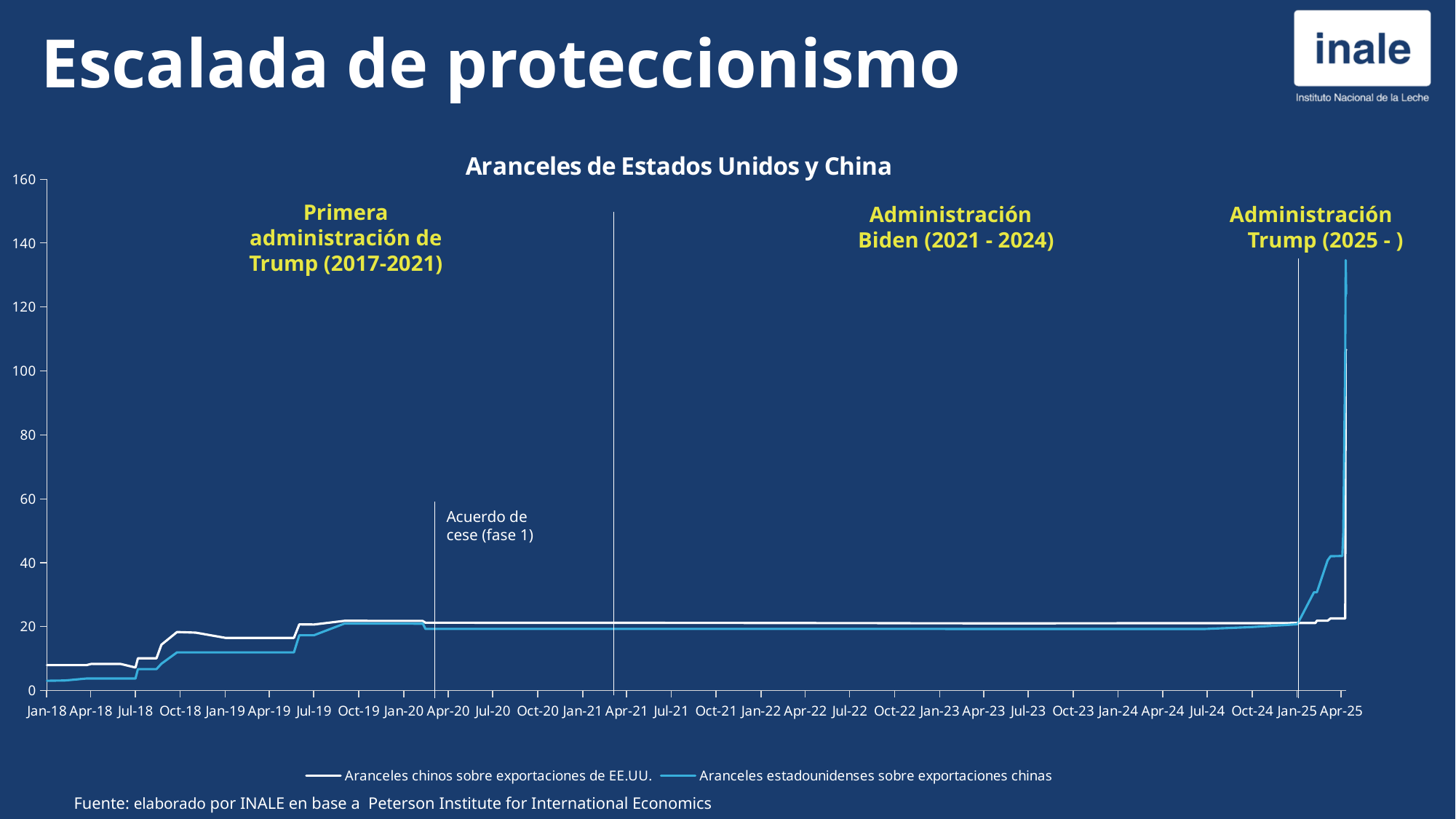
Which series is drawn in light blue according to the legend? Aranceles estadounidenses sobre exportaciones chinas Is the value of Aranceles chinos sobre exportaciones de EE.UU. at Jan-18 greater or less than 20? less At Jan-19, which series has the higher value: Aranceles chinos sobre exportaciones de EE.UU. or Aranceles estadounidenses sobre exportaciones chinas? Aranceles chinos sobre exportaciones de EE.UU. How many series does the legend list? 2 How many date labels are shown on the x axis? 30 What is the title of the chart? Aranceles de Estados Unidos y China What kind of chart is shown on the slide? line chart Is the value of Aranceles chinos sobre exportaciones de EE.UU. at Jan-22 greater or less than 40? less Does the Aranceles estadounidenses sobre exportaciones chinas series rise or fall between Jan-18 and Jul-19? rise Is the value of Aranceles estadounidenses sobre exportaciones chinas at Jan-18 greater or less than 20? less What is the highest value shown on the y axis? 160